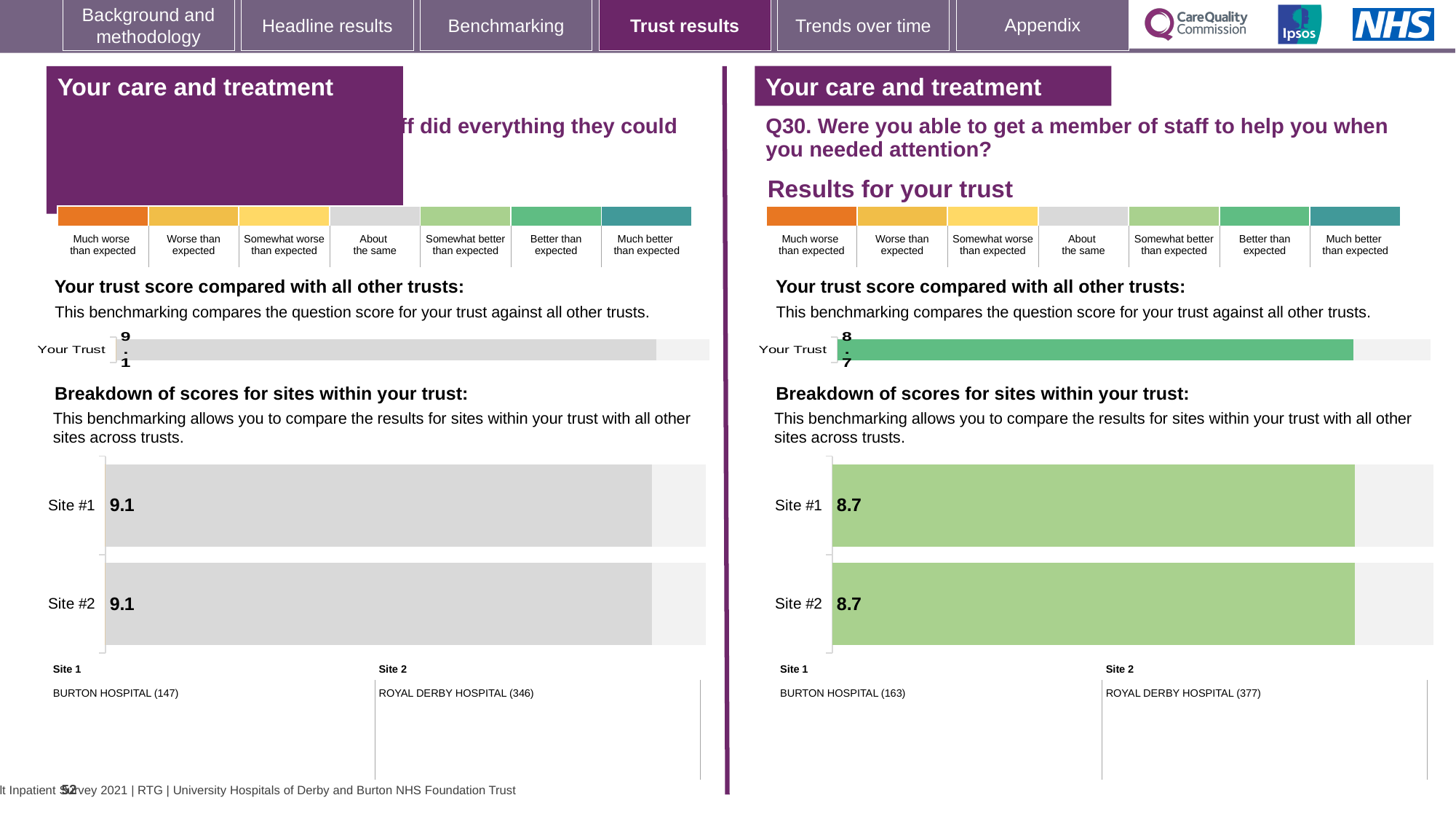
How many sites are shown in the right-hand panel's 'Breakdown of scores for sites within your trust' chart? 2 In the right-hand panel's site breakdown chart, what is the difference between the scores for Site #1 and Site #2? 0 In the left-hand panel's site breakdown chart, which hospital is listed as Site 2? ROYAL DERBY HOSPITAL (346) In the right-hand panel's site breakdown chart, is the score for Site #2 greater or less than 8? greater What type of chart is used for the site breakdown on the left-hand panel? Bar chart On the left-hand panel, what is the score shown for Your Trust in the 'Your trust score compared with all other trusts' chart? 9.1 In the right-hand panel's 'Breakdown of scores for sites within your trust' chart, what is the score for Site #1? 8.7 What is the difference between the Your Trust score on the left-hand panel and the Your Trust score on the right-hand panel (Q30)? 0.4 Which is larger: the Your Trust score on the left-hand panel or the Your Trust score on the right-hand panel (Q30)? Left-hand panel (9.1) In the left-hand panel's 'Breakdown of scores for sites within your trust' chart, what is the score for Site #2? 9.1 In the right-hand panel's site breakdown chart, which hospital is listed as Site 1? BURTON HOSPITAL (163) On the right-hand panel (Q30), what is the score shown for Your Trust in the 'Your trust score compared with all other trusts' chart? 8.7